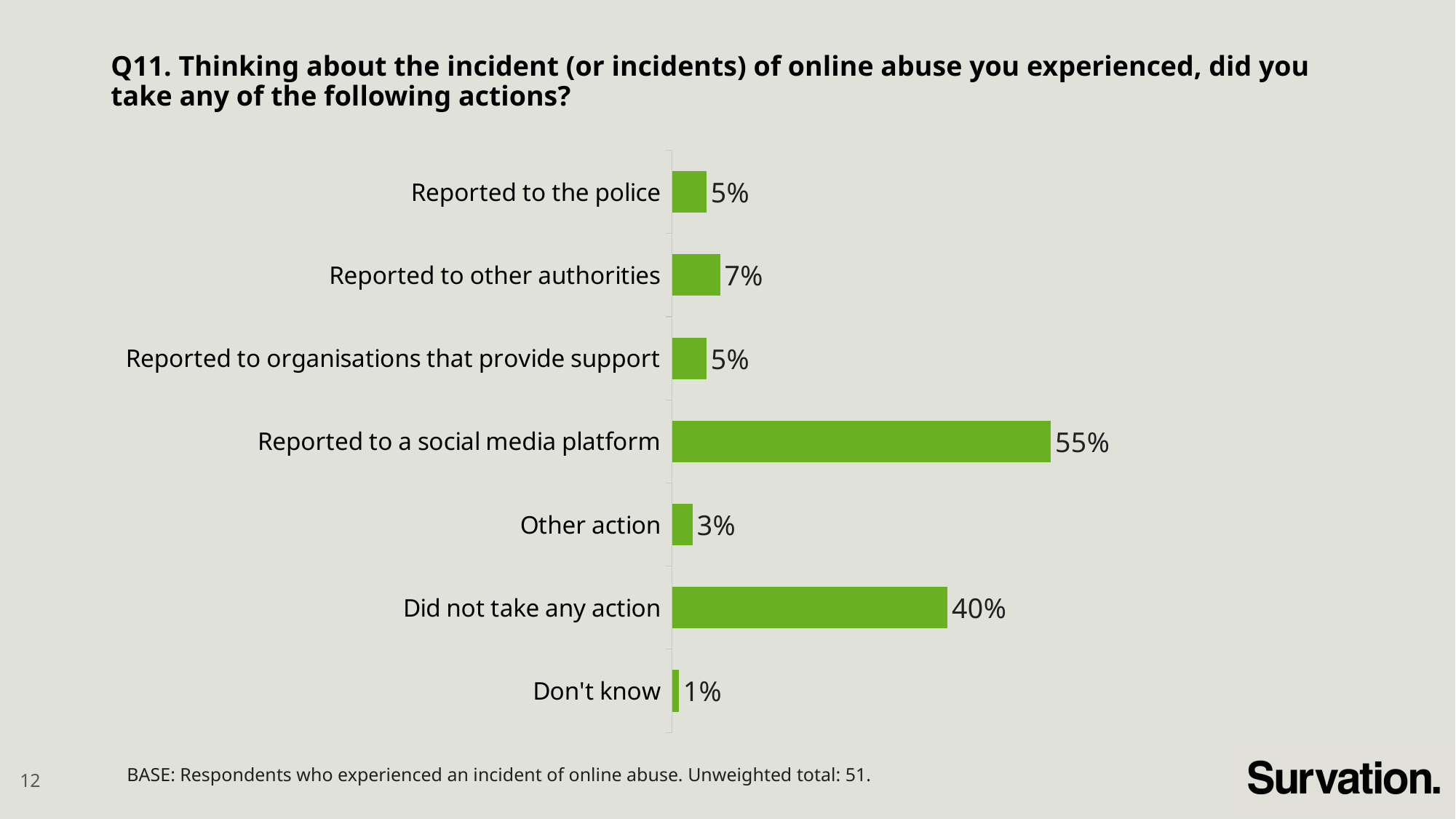
Which is larger: the percentage who reported to other authorities or the percentage who took other action? Reported to other authorities What percentage of respondents answered 'Don't know'? 1% What percentage of respondents reported the incident to a social media platform? 55% What percentage of respondents reported to other authorities? 7% How many categories are shown in the chart? 7 What type of chart is shown on the slide? Bar chart What percentage of respondents reported the incident to the police? 5% Which category has the lowest percentage? Don't know Which action has the highest percentage? Reported to a social media platform What is the difference between the percentage who reported to a social media platform and the percentage who did not take any action? 15% What is the unweighted total of respondents stated in the base note? 51 What percentage of respondents did not take any action? 40%